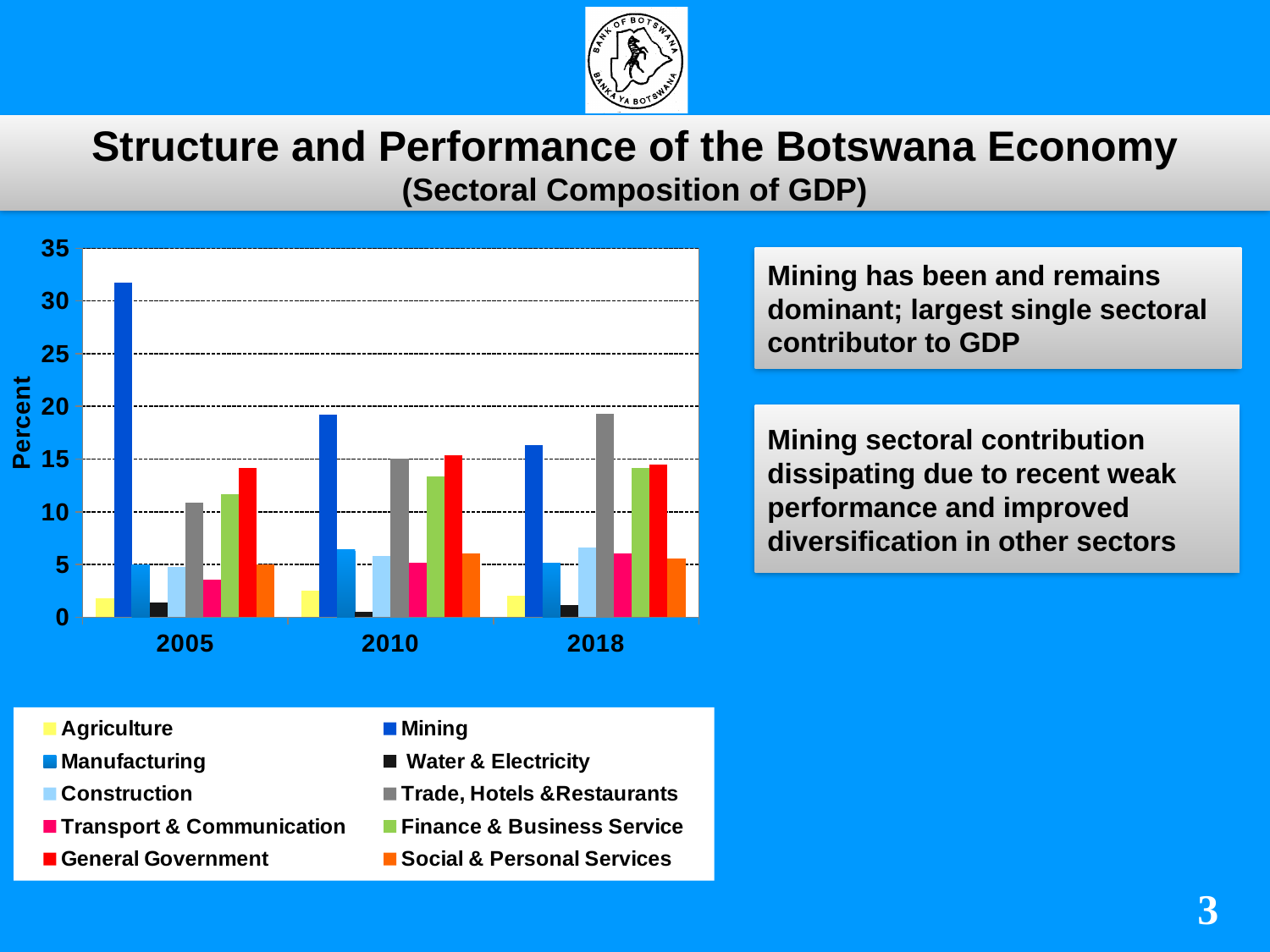
In 2010, which is larger: Mining or Trade, Hotels & Restaurants? Mining How many years are shown on the x axis of the chart? 3 How many series does the chart legend list? 10 Is the value for Trade, Hotels & Restaurants in 2018 greater or less than 15? greater Which sector has the lowest value in 2010? Water & Electricity Which sector has the highest value in 2005? Mining Which sector has the highest value in 2018? Trade, Hotels & Restaurants Does the value for Mining rise or fall from 2005 to 2018? fall What is the label on the y axis of the chart? Percent Is the value for Mining in 2018 greater or less than 20? less Is the value for Mining in 2005 greater or less than 30? greater What type of chart is shown on the slide? bar chart